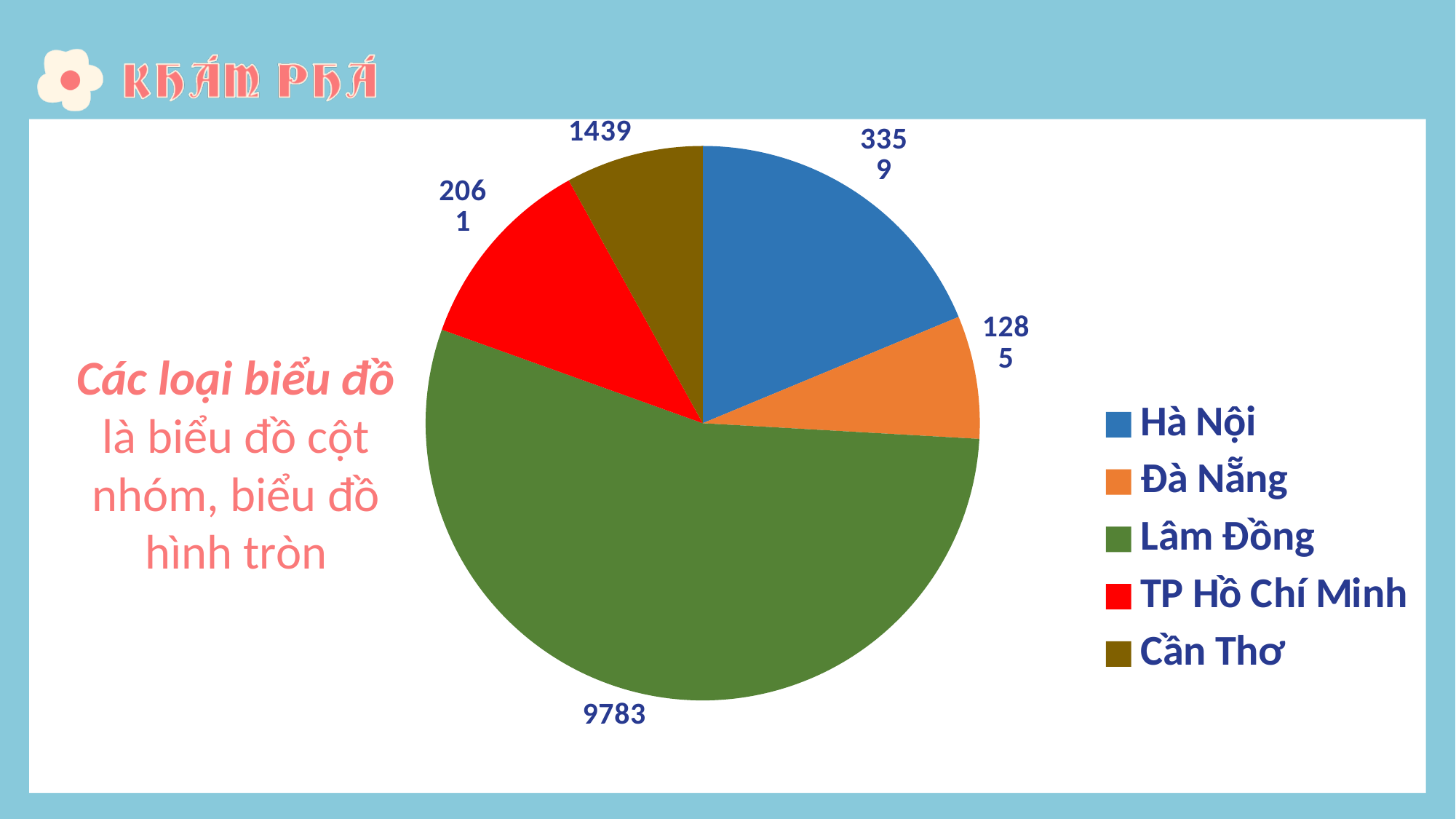
What is the difference between the values for Hà Nội and Đà Nẵng? 2074 Which category has the largest slice of the pie? Lâm Đồng What is the value for Hà Nội? 3359 What colour is the slice for TP Hồ Chí Minh? red What is the value for TP Hồ Chí Minh? 2061 Which category has the smallest slice of the pie? Đà Nẵng What is the difference between the values for Lâm Đồng and Hà Nội? 6424 Which is larger, the value for TP Hồ Chí Minh or the value for Cần Thơ? TP Hồ Chí Minh What is the value for Lâm Đồng? 9783 What is the value for Cần Thơ? 1439 What kind of chart is shown on the slide? pie chart How many categories does the pie chart have? 5